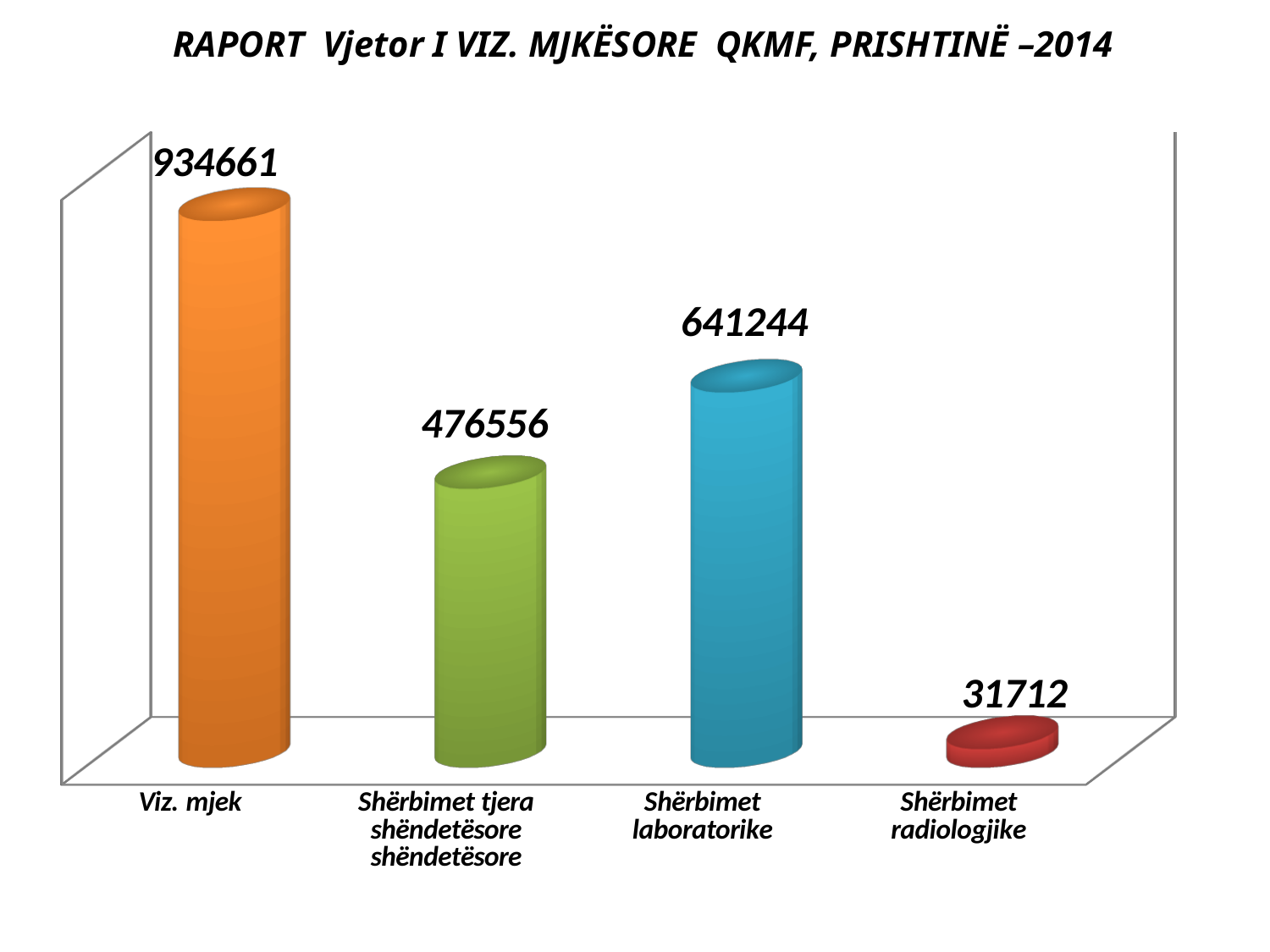
How many categories are shown in the chart? 4 What is the value for Shërbimet radiologjike? 31712 Which category has the highest value? Viz. mjek What is the difference between the values for Viz. mjek and Shërbimet laboratorike? 293417 Which category has the lowest value? Shërbimet radiologjike What is the difference between the values for Shërbimet laboratorike and Shërbimet tjera shëndetësore shëndetësore? 164688 What is the title of the chart? RAPORT Vjetor I VIZ. MJKËSORE QKMF, PRISHTINË –2014 What is the value for Viz. mjek? 934661 What is the value for Shërbimet laboratorike? 641244 What is the value for Shërbimet tjera shëndetësore shëndetësore? 476556 Which is larger, the value for Shërbimet laboratorike or the value for Shërbimet tjera shëndetësore shëndetësore? Shërbimet laboratorike What kind of chart is shown on the slide? Bar chart